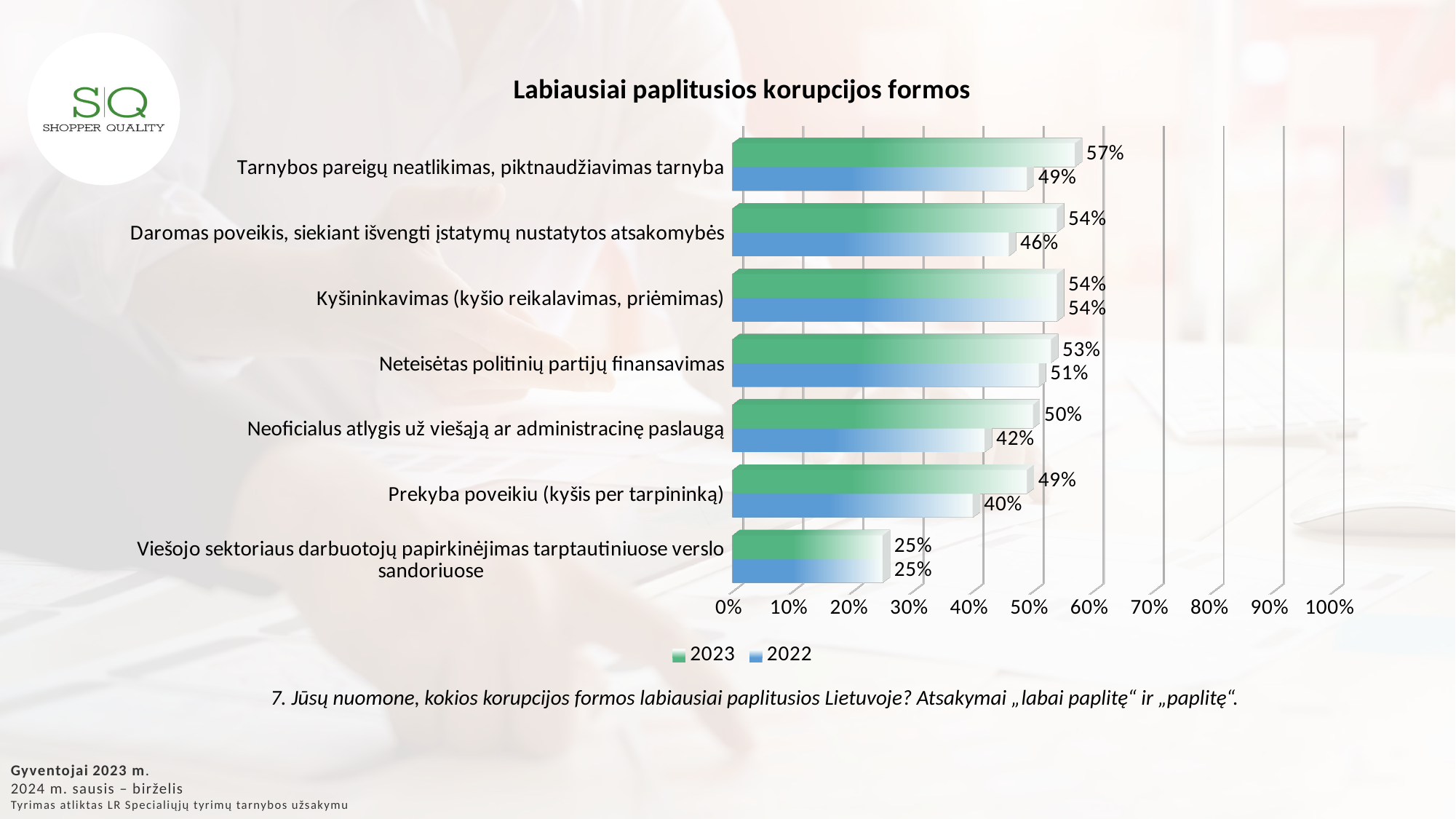
Which category has the highest 2023 value? Tarnybos pareigų neatlikimas, piktnaudžiavimas tarnyba Which category has the lowest 2022 value? Viešojo sektoriaus darbuotojų papirkinėjimas tarptautiniuose verslo sandoriuose What is the 2023 value for "Tarnybos pareigų neatlikimas, piktnaudžiavimas tarnyba"? 57% Which is larger: the 2023 value for "Neteisėtas politinių partijų finansavimas" or the 2022 value for "Daromas poveikis, siekiant išvengti įstatymų nustatytos atsakomybės"? 2023 value for Neteisėtas politinių partijų finansavimas What is the difference between the 2023 and 2022 values for "Prekyba poveikiu (kyšis per tarpininką)"? 9% What is the difference between the 2023 and 2022 values for "Tarnybos pareigų neatlikimas, piktnaudžiavimas tarnyba"? 8% How many series does the legend list? 2 What is the title of the chart? Labiausiai paplitusios korupcijos formos What is the 2022 value for "Neoficialus atlygis už viešąją ar administracinę paslaugą"? 42% What kind of chart is shown on the slide? Bar chart How many categories are shown on the chart? 7 What is the 2022 value for "Prekyba poveikiu (kyšis per tarpininką)"? 40%